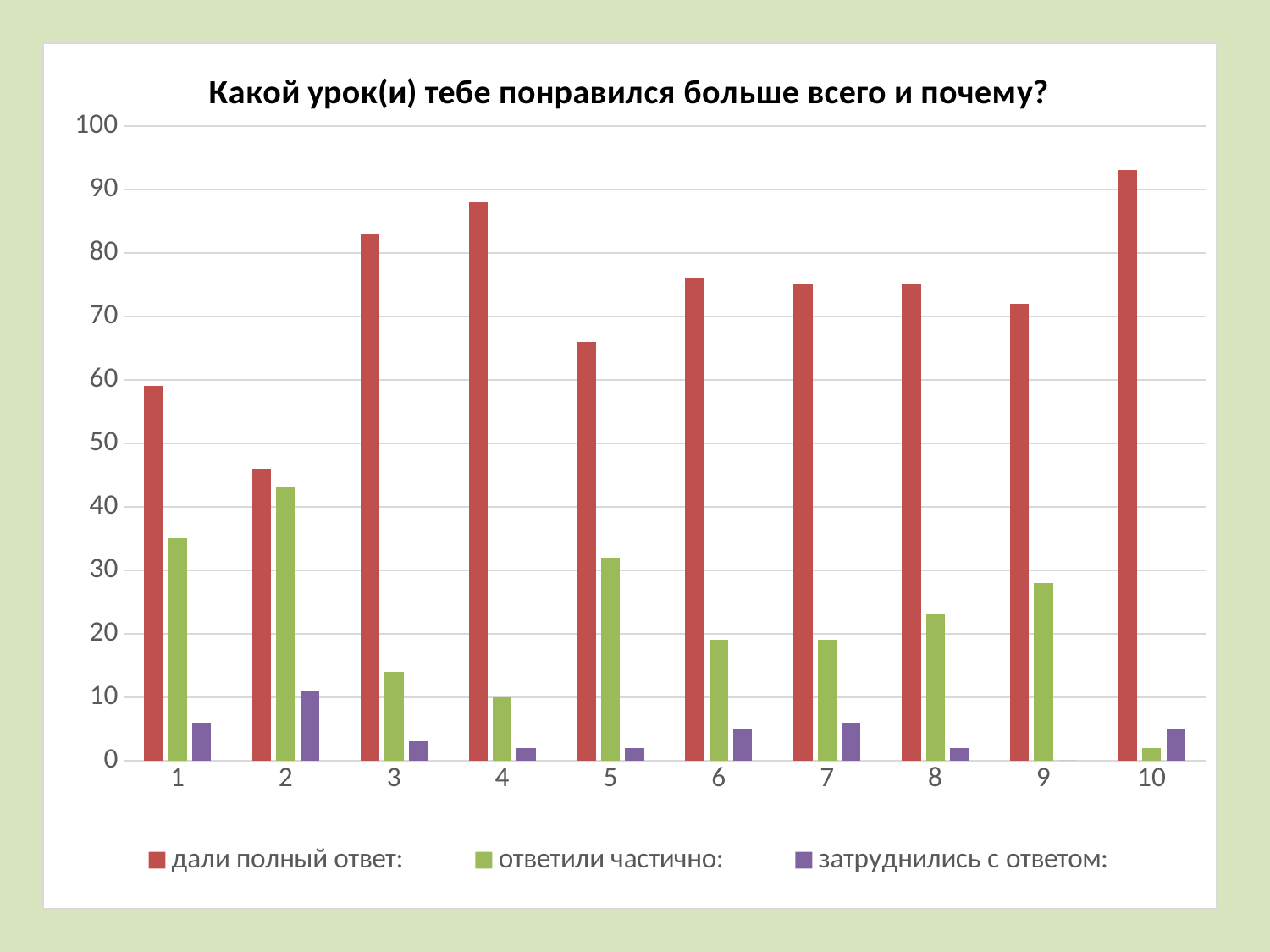
Which category has the lowest value for "дали полный ответ:"? 2 How many categories are shown along the x axis? 10 Is the value for "дали полный ответ:" in category 1 greater or less than 50? greater How many series does the legend list? 3 What kind of chart is shown on the slide? bar chart Is the value for "ответили частично:" in category 3 greater or less than 20? less What is the title of the chart? Какой урок(и) тебе понравился больше всего и почему? Which category has the highest value for "ответили частично:"? 2 Which category has the highest value for "дали полный ответ:"? 10 Is the value for "дали полный ответ:" in category 5 greater or less than 60? greater Which is larger: the value for "дали полный ответ:" in category 3 or in category 4? category 4 Which is larger: the value for "ответили частично:" in category 8 or in category 9? category 9